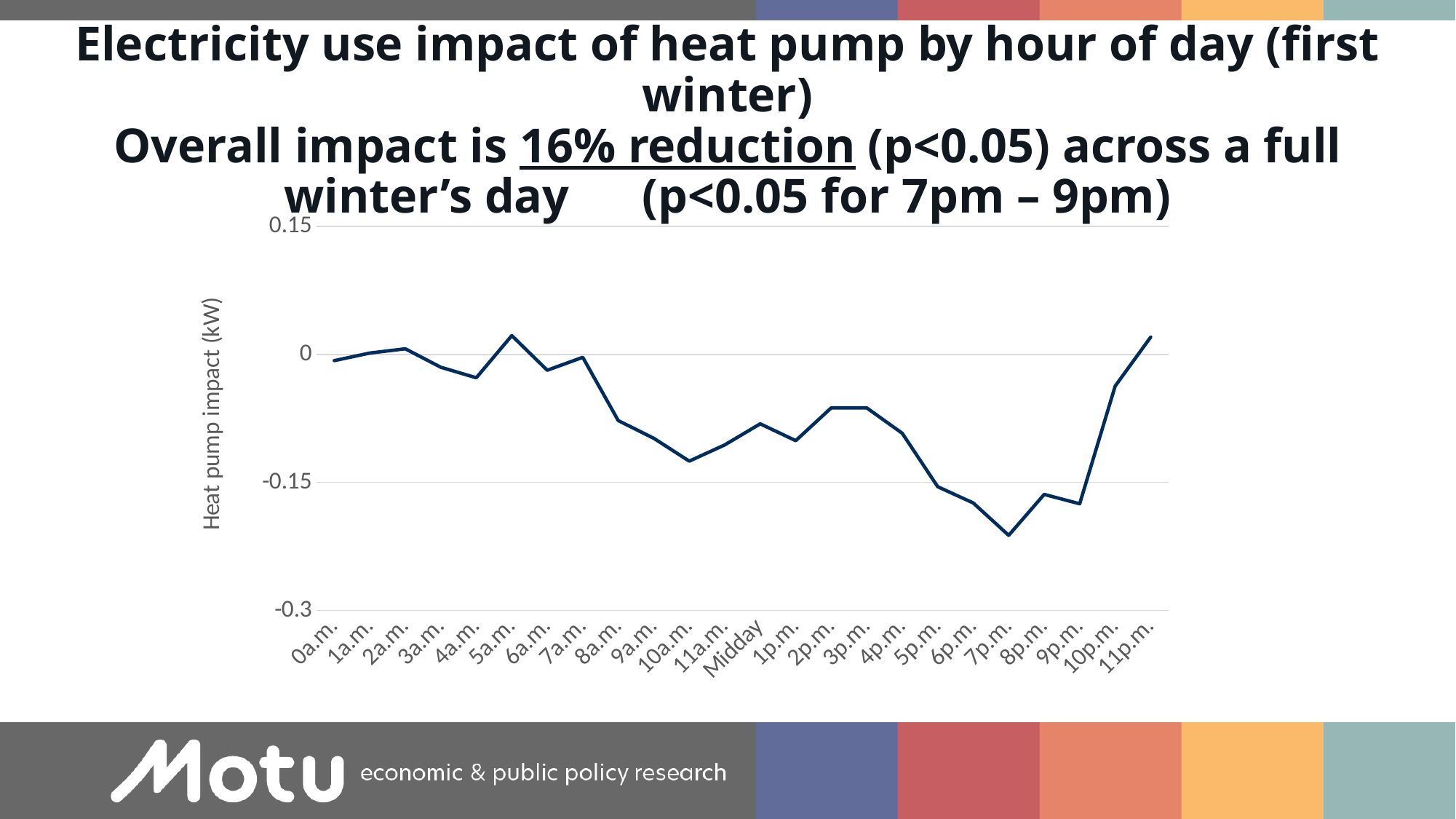
Is the value for 10a.m. greater or less than -0.15? greater Is the value for 4a.m. greater or less than 0? less Is the value for 6p.m. greater or less than -0.15? less What is the label on the vertical axis of the chart? Heat pump impact (kW) Do the values rise or fall from 3p.m. to 7p.m.? fall Do the values rise or fall from 7p.m. to 11p.m.? rise Which has the larger heat pump impact value, 3p.m. or 7p.m.? 3p.m. What kind of chart is shown on the slide? line chart At which hour of the day is the heat pump impact lowest? 7p.m. How many hourly points are plotted along the x axis? 24